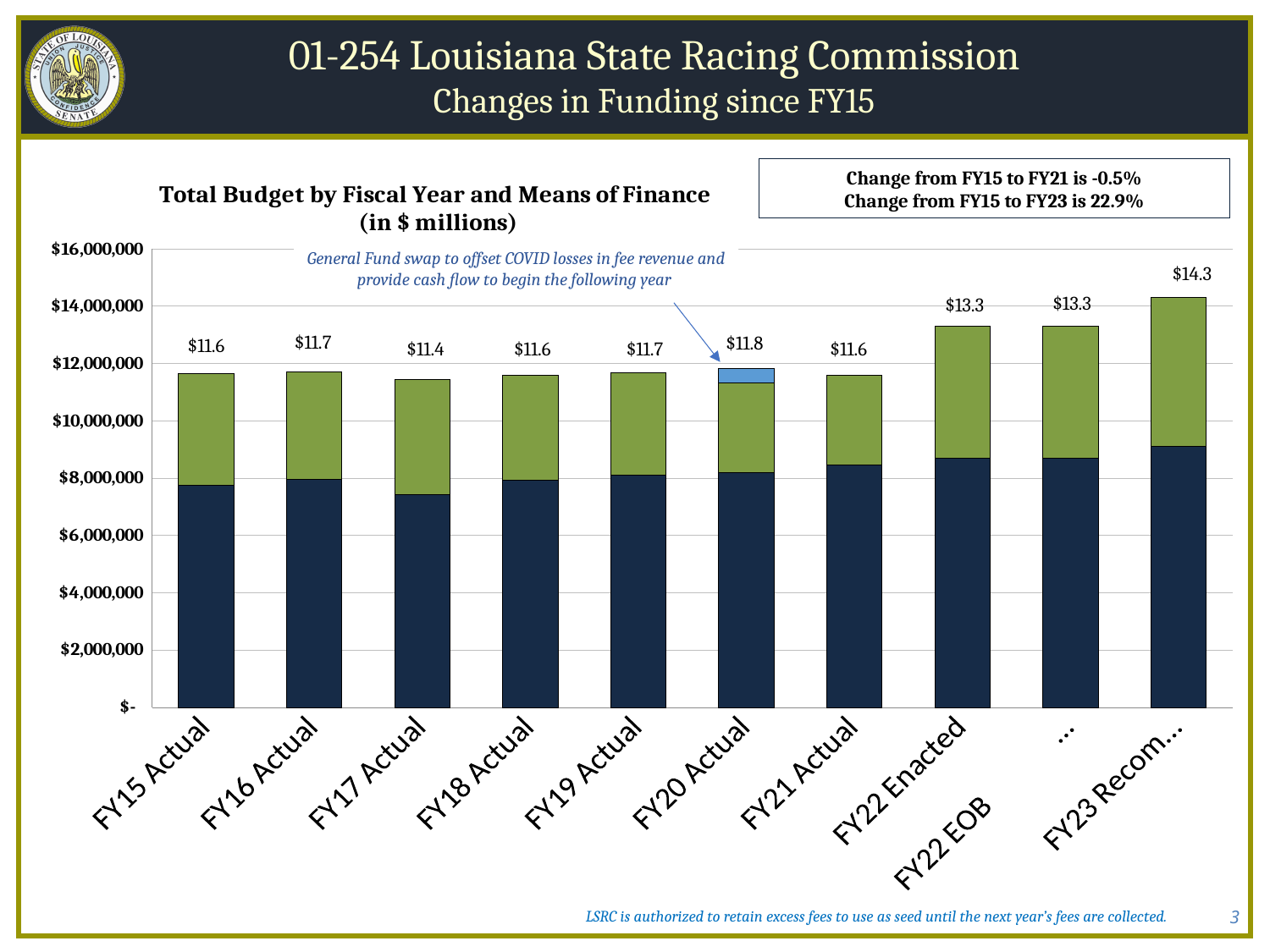
Which is larger, the total budget for FY22 Enacted or for FY21 Actual? FY22 Enacted Is the dark blue segment for FY15 Actual greater or less than $8,000,000? less Which bar has the highest total budget? FY23 Recom... (the last bar) What is the total budget shown for FY20 Actual? $11.8 What is the total budget shown for FY15 Actual? $11.6 How many bars are shown in the chart? 10 What kind of chart is shown on the slide? Stacked bar chart What is the title of the chart? Total Budget by Fiscal Year and Means of Finance (in $ millions) What is the total budget shown for FY22 Enacted? $13.3 Which fiscal year bar has the lowest total budget? FY17 Actual What is the difference between the total budget for the FY23 bar and FY15 Actual, in $ millions? $2.7 Is the dark blue segment for FY22 Enacted greater or less than $8,000,000? greater